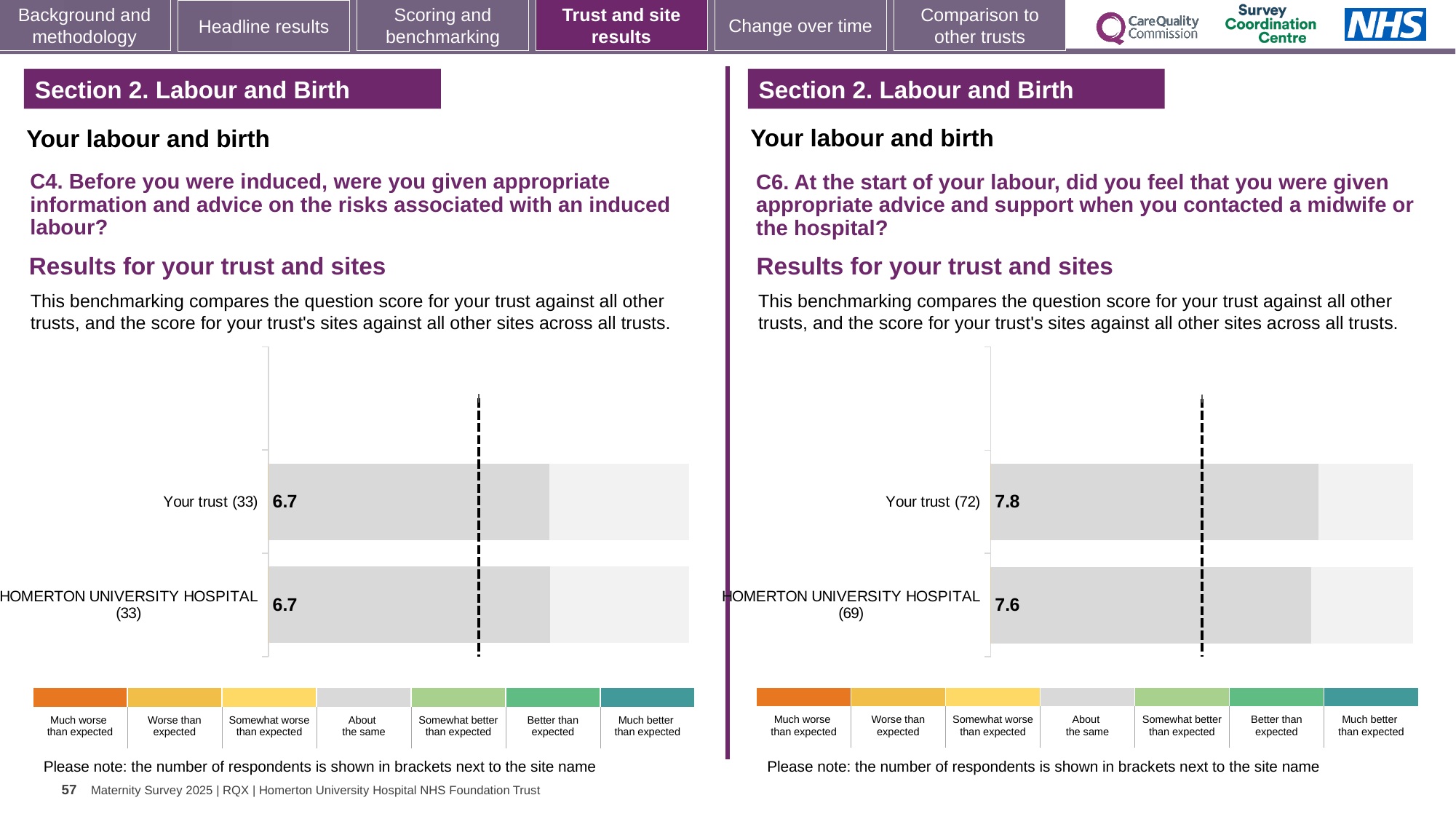
What type of chart is used for the C6 results on the right? Bar chart In the C4 chart on the left, what is the score for Your trust? 6.7 In the C6 chart on the right, what is the difference between the score for Your trust and the score for HOMERTON UNIVERSITY HOSPITAL? 0.2 In the C6 chart on the right, what is the score for HOMERTON UNIVERSITY HOSPITAL? 7.6 How many bars are plotted in the C4 chart on the left? 2 In the C6 chart on the right, which has the higher score, Your trust or HOMERTON UNIVERSITY HOSPITAL? Your trust In the C4 chart on the left, what is the difference between the score for Your trust and the score for HOMERTON UNIVERSITY HOSPITAL? 0 In the C4 chart on the left, what is the score for HOMERTON UNIVERSITY HOSPITAL? 6.7 In the C6 chart on the right, what is the score for Your trust? 7.8 In the C4 chart on the left, how many respondents are shown in brackets for Your trust? 33 In the C6 chart on the right, how many respondents are shown in brackets for HOMERTON UNIVERSITY HOSPITAL? 69 How many bars are plotted in the C6 chart on the right? 2